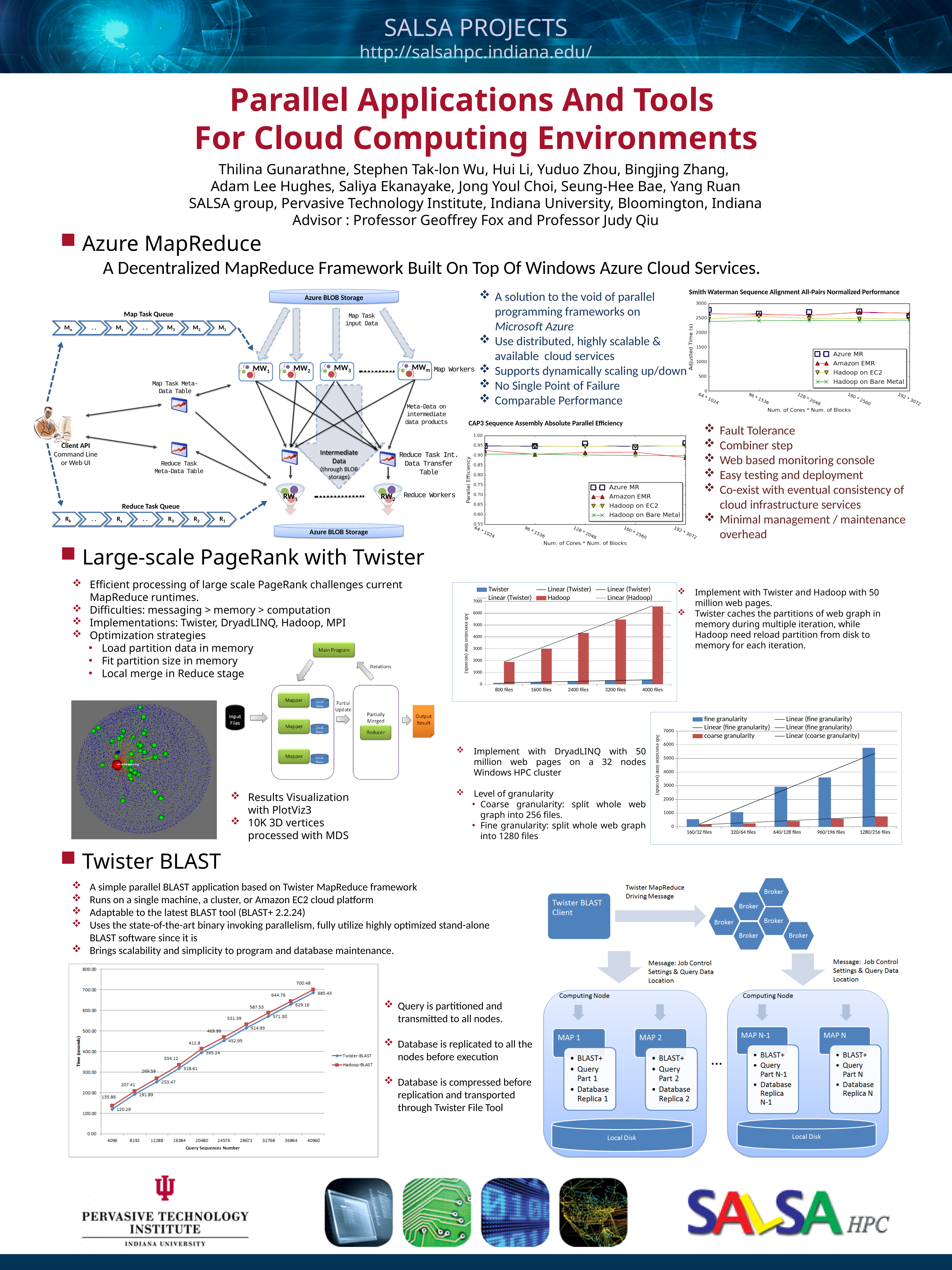
In the Twister BLAST chart (bottom left), what is the Hadoop-BLAST time for 40960 query sequences? 700.48 In the Twister BLAST chart (bottom left), which series has the larger value at 32768 query sequences, Twister-BLAST or Hadoop-BLAST? Hadoop-BLAST In the Twister BLAST chart (bottom left), how many query sequence number categories are shown on the x axis? 10 In the Smith Waterman Sequence Alignment All-Pairs Normalized Performance chart, how many series does the legend list? 4 In the Twister BLAST chart (bottom left), what is the difference between the Hadoop-BLAST and Twister-BLAST times at 20480 query sequences? 17.56 In the PageRank chart comparing Twister and Hadoop (x axis 800 files to 4000 files), which category has the highest Hadoop job execution time? 4000 files In the Twister BLAST chart (bottom left), how many series does the legend list? 2 In the Twister BLAST chart (bottom left), what is the Twister-BLAST time for 4096 query sequences? 120.29 In the PageRank chart comparing Twister and Hadoop, is the Hadoop value for 4000 files greater or less than 6000? greater In the Twister BLAST chart (bottom left), do the times rise or fall as the query sequences number increases? rise In the fine granularity vs coarse granularity chart, is the fine granularity value for 1280/256 files greater or less than 5000? greater What kind of chart is the CAP3 Sequence Assembly Absolute Parallel Efficiency chart? line chart